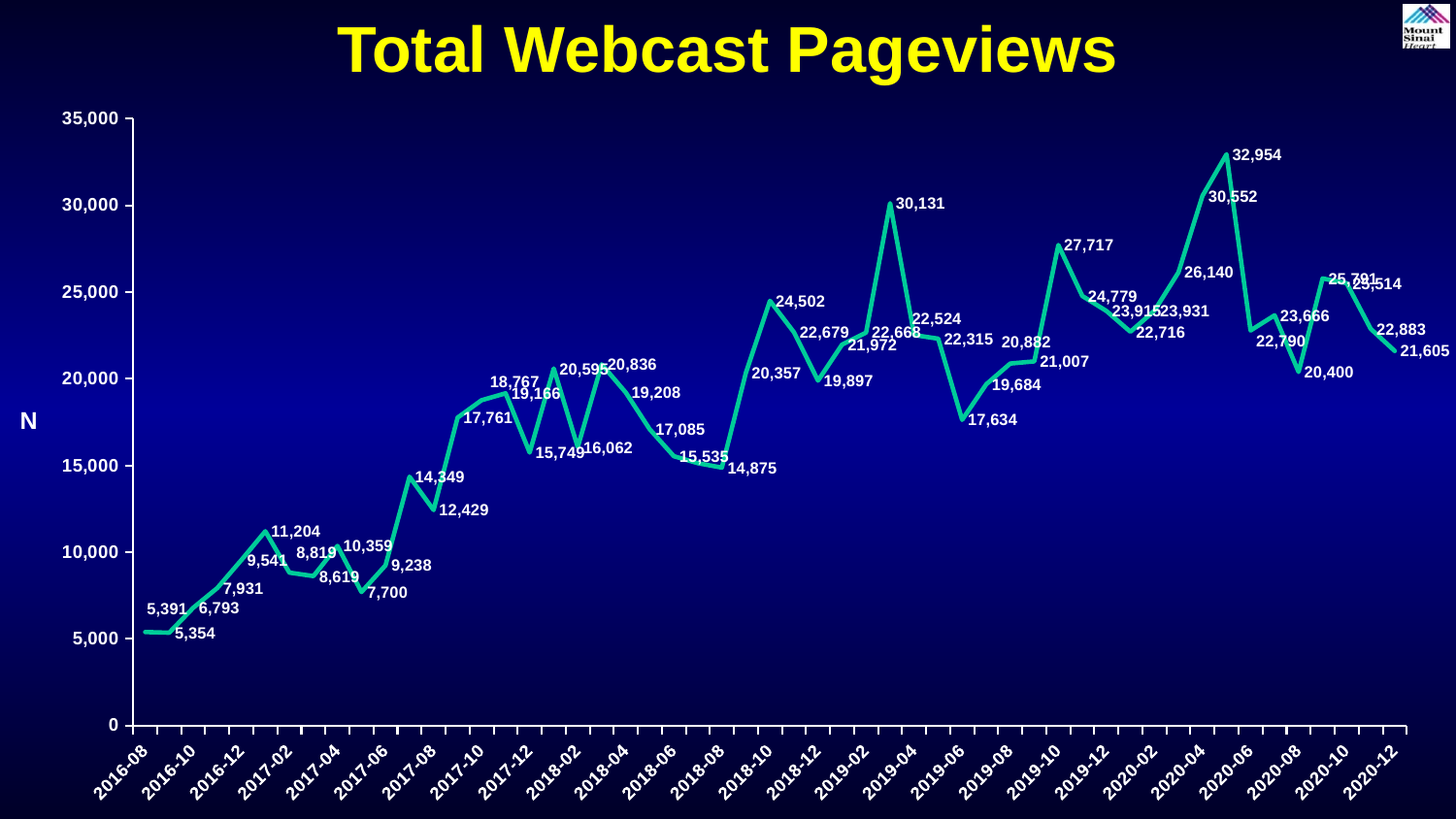
What is the lowest value labeled on the line? 5,354 What is the difference between the highest labeled value (32,954) and the lowest labeled value (5,354)? 27,600 What is the highest value labeled on the line? 32,954 What is the label on the vertical axis? N What is the title of the chart? Total Webcast Pageviews What is the value for the first point, 2016-08? 5,391 What is the value for the last point, 2020-12? 21,605 Which is larger, the peak labeled 32,954 or the peak labeled 30,131? 32,954 What kind of chart is shown on the slide? line chart Overall, do the pageview values rise or fall from 2016-08 to 2020-12? rise Is the value for 2016-08 greater or less than 10,000? less How many lines are plotted on the chart? 1